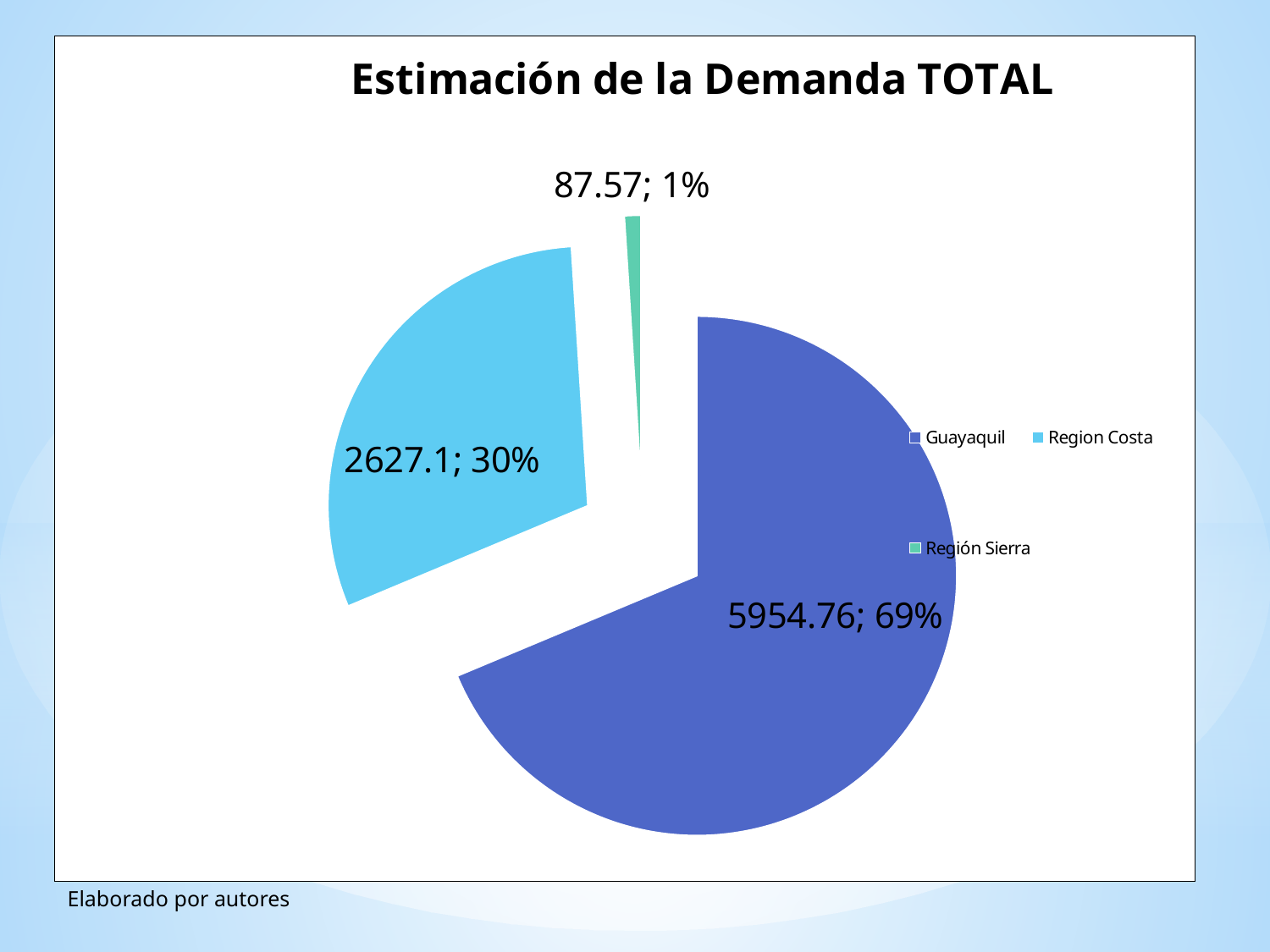
What is the difference between the values for Guayaquil and Region Costa? 3327.66 Which category has the largest slice? Guayaquil What share of the pie does Guayaquil represent? 69% What is the value for Region Costa? 2627.1 Which category has the smallest slice? Región Sierra What kind of chart is shown on the slide? Pie chart How many slices does the pie chart have? 3 What is the value for Guayaquil? 5954.76 What is the title of the chart? Estimación de la Demanda TOTAL What is the value for Región Sierra? 87.57 Which is larger, the value for Region Costa or the value for Región Sierra? Region Costa What share of the pie does Region Costa represent? 30%